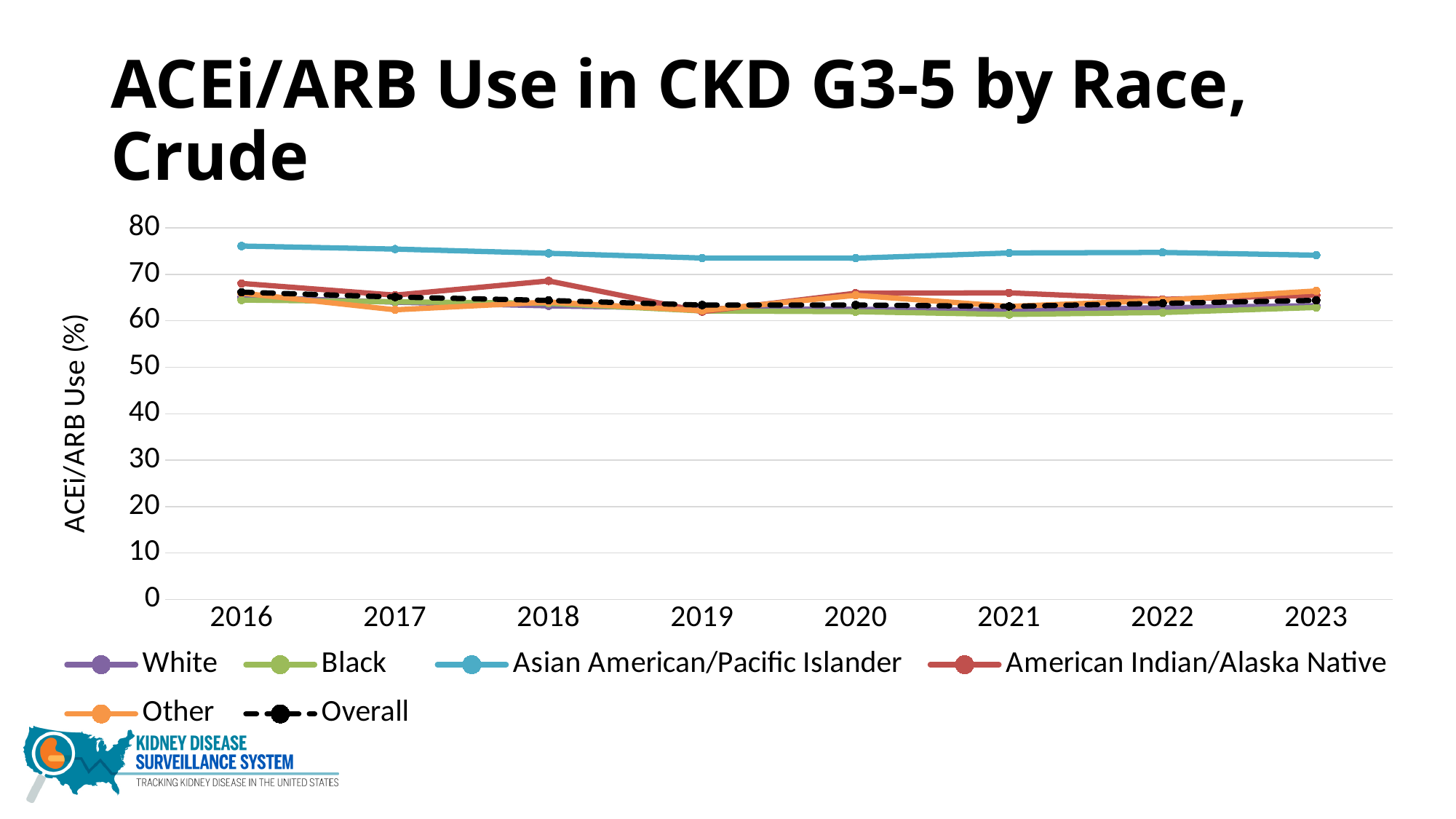
What is the label on the y axis? ACEi/ARB Use (%) Is the value for White in 2019 greater or less than 70? less How many years are shown on the x axis? 8 Does the Asian American/Pacific Islander line rise or fall from 2016 to 2019? fall In 2018, which is larger: the value for American Indian/Alaska Native or the value for Black? American Indian/Alaska Native In 2020, which is larger: the value for Asian American/Pacific Islander or the value for Black? Asian American/Pacific Islander Which race group has the highest ACEi/ARB use in 2016? Asian American/Pacific Islander Which race group has the highest ACEi/ARB use in 2023? Asian American/Pacific Islander Is the value for Asian American/Pacific Islander in 2016 greater or less than 70? greater What kind of chart is shown on the slide? line chart How many series does the legend list? 6